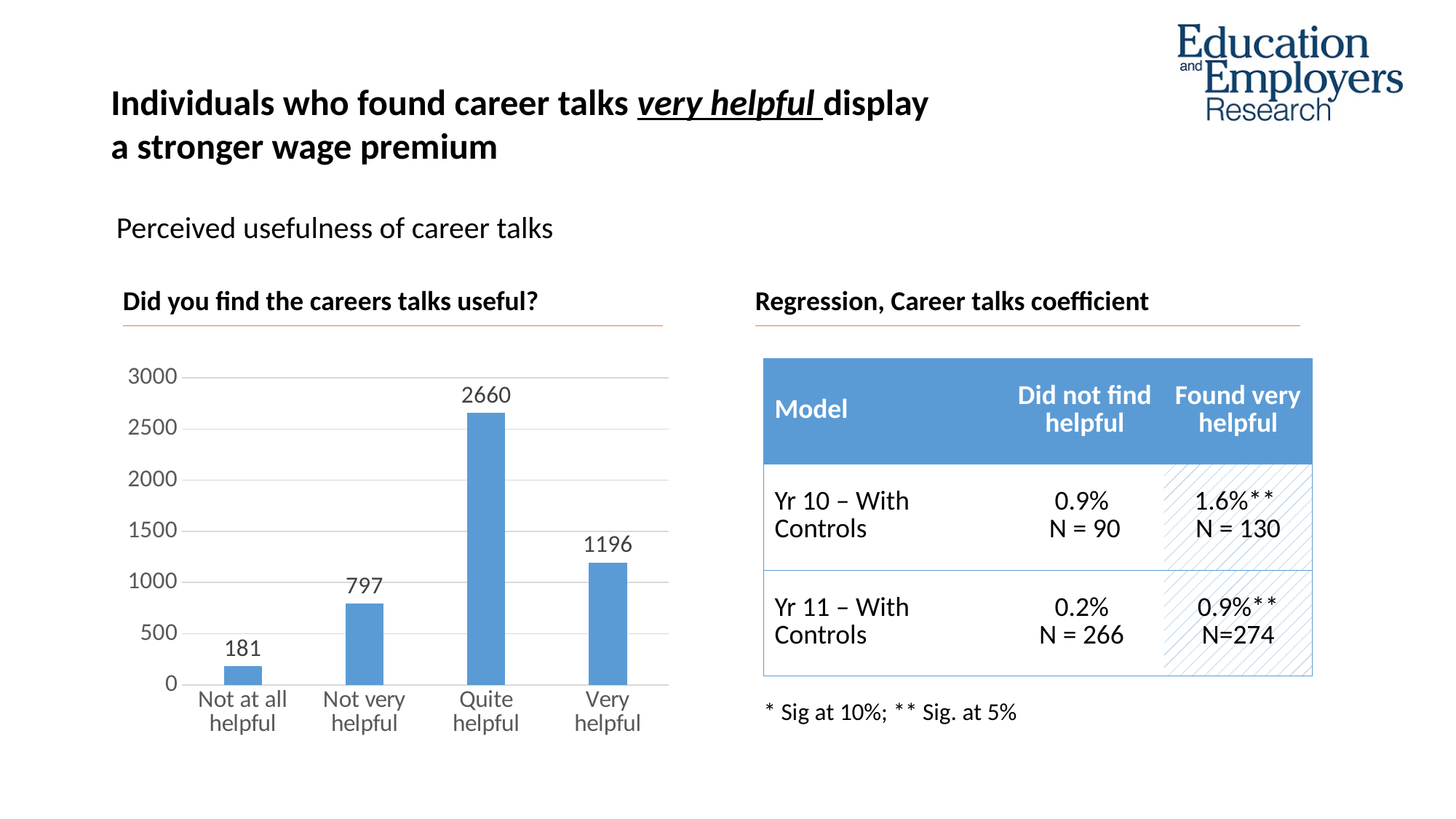
In the chart 'Did you find the careers talks useful?', what is the value for 'Quite helpful'? 2660 In the chart 'Did you find the careers talks useful?', which is larger: 'Not very helpful' or 'Very helpful'? Very helpful In the chart 'Did you find the careers talks useful?', is the value for 'Not very helpful' greater or less than 1000? less In the chart 'Did you find the careers talks useful?', which category has the highest value? Quite helpful In the chart 'Did you find the careers talks useful?', what is the value for 'Very helpful'? 1196 In the chart 'Did you find the careers talks useful?', what is the difference between 'Not very helpful' and 'Not at all helpful'? 616 In the chart 'Did you find the careers talks useful?', what is the value for 'Not at all helpful'? 181 How many categories are shown in the chart 'Did you find the careers talks useful?'? 4 In the chart 'Did you find the careers talks useful?', what is the difference between 'Quite helpful' and 'Very helpful'? 1464 In the chart 'Did you find the careers talks useful?', which category has the lowest value? Not at all helpful What kind of chart is 'Did you find the careers talks useful?'? Bar chart What is the maximum value shown on the vertical axis of the chart 'Did you find the careers talks useful?'? 3000